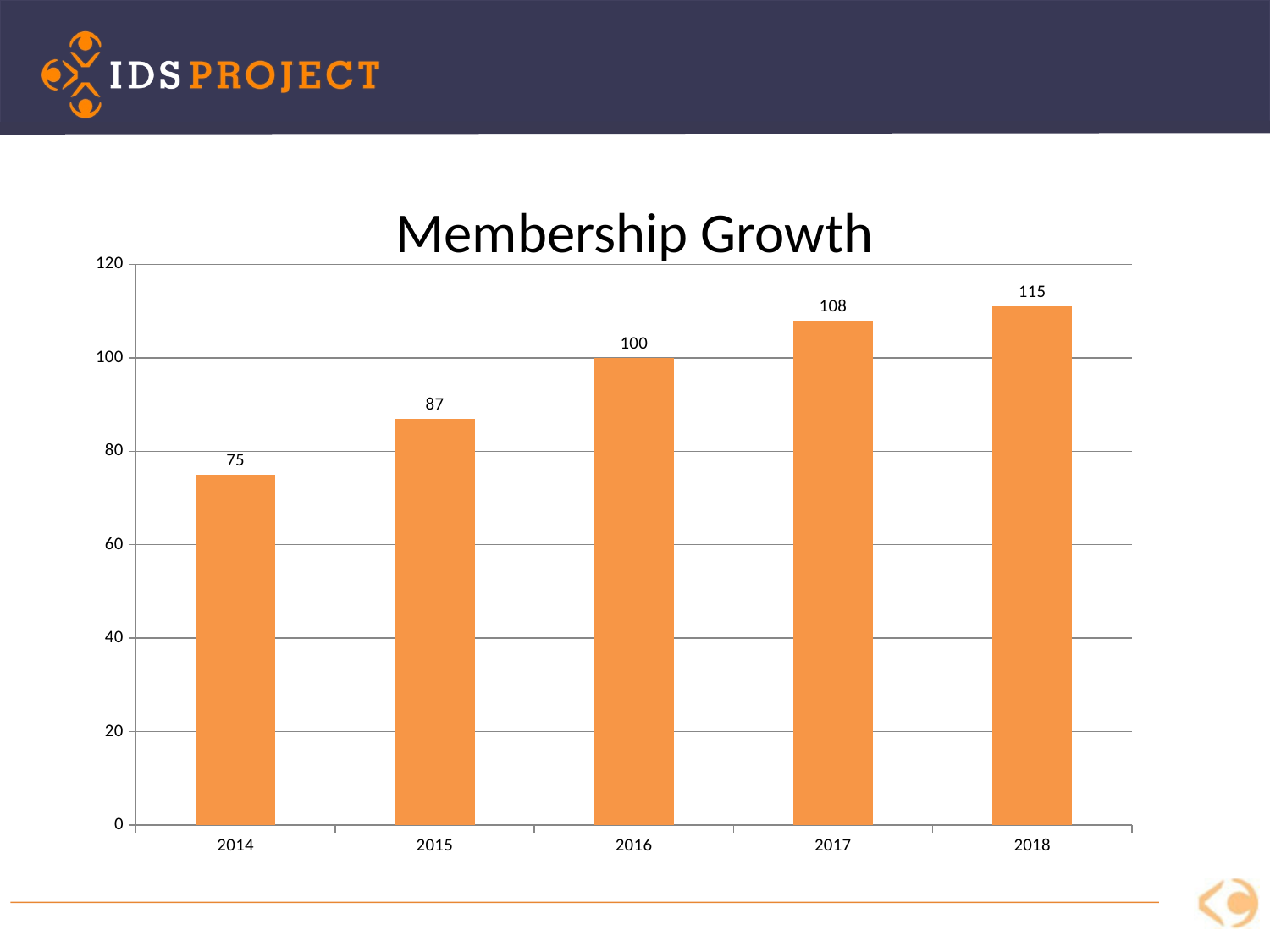
What is the difference between the values for 2017 and 2015? 21 What kind of chart is this? bar chart Do the values rise or fall from 2014 to 2018? rise Is the value for 2015 greater or less than 80? greater What is the value for 2014? 75 What is the value for 2018? 115 Which is larger, the value for 2015 or the value for 2017? 2017 What is the value for 2016? 100 Which year has the lowest value? 2014 Which year has the highest value? 2018 How many years are shown on the x axis? 5 What is the difference between the values for 2018 and 2014? 40